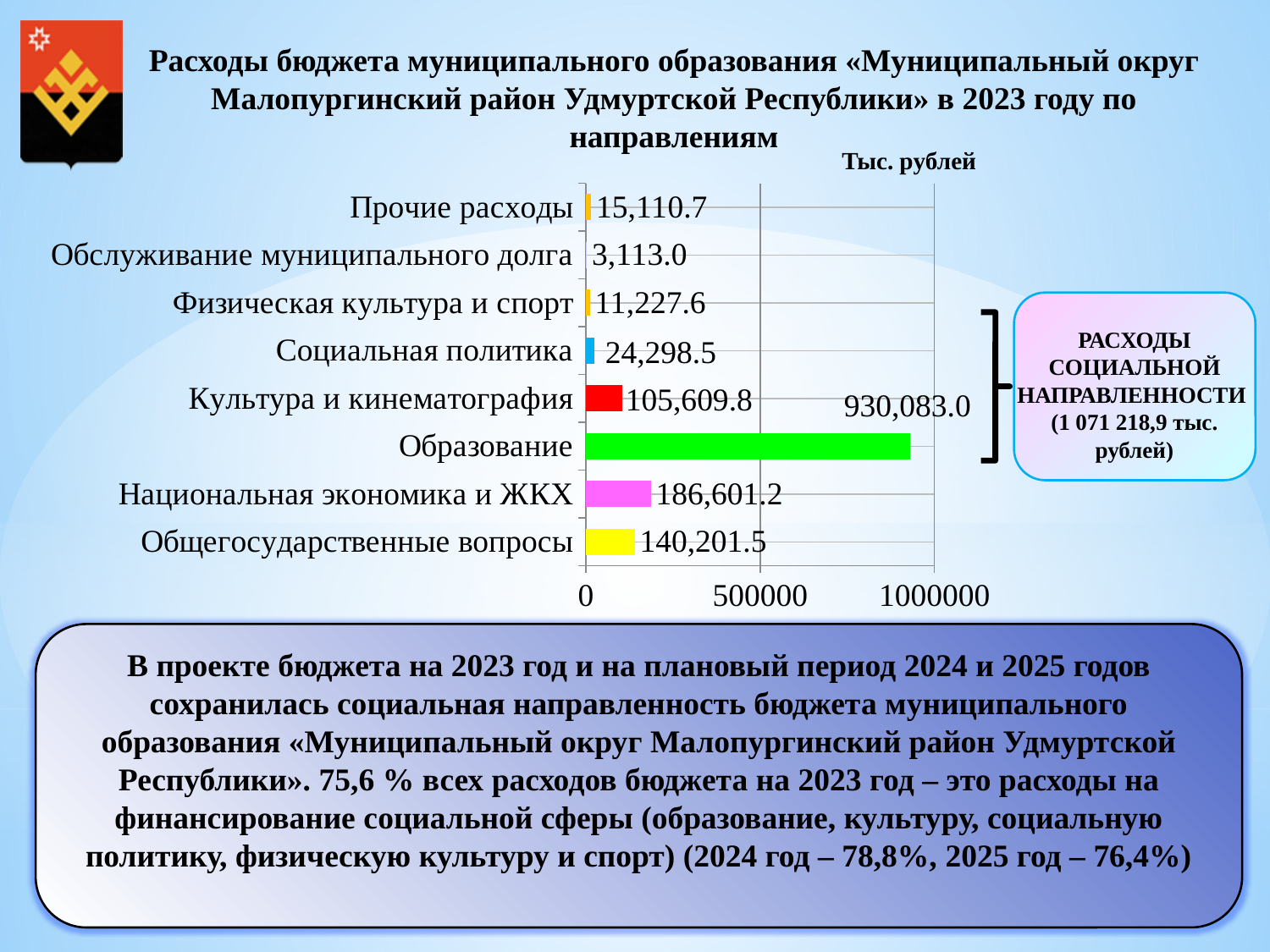
What kind of chart is shown on the slide? bar chart Is the value for Образование greater or less than 500000? greater What is the value for Национальная экономика и ЖКХ? 186,601.2 What is the difference between Социальная политика and Физическая культура и спорт? 13,070.9 What is the value for Образование? 930,083.0 Which is larger, Общегосударственные вопросы or Культура и кинематография? Общегосударственные вопросы What is the value for Культура и кинематография? 105,609.8 What is the value for Обслуживание муниципального долга? 3,113.0 Which category has the lowest value? Обслуживание муниципального долга How many categories are shown in the chart? 8 Which category has the highest value? Образование What is the difference between Национальная экономика и ЖКХ and Общегосударственные вопросы? 46,399.7